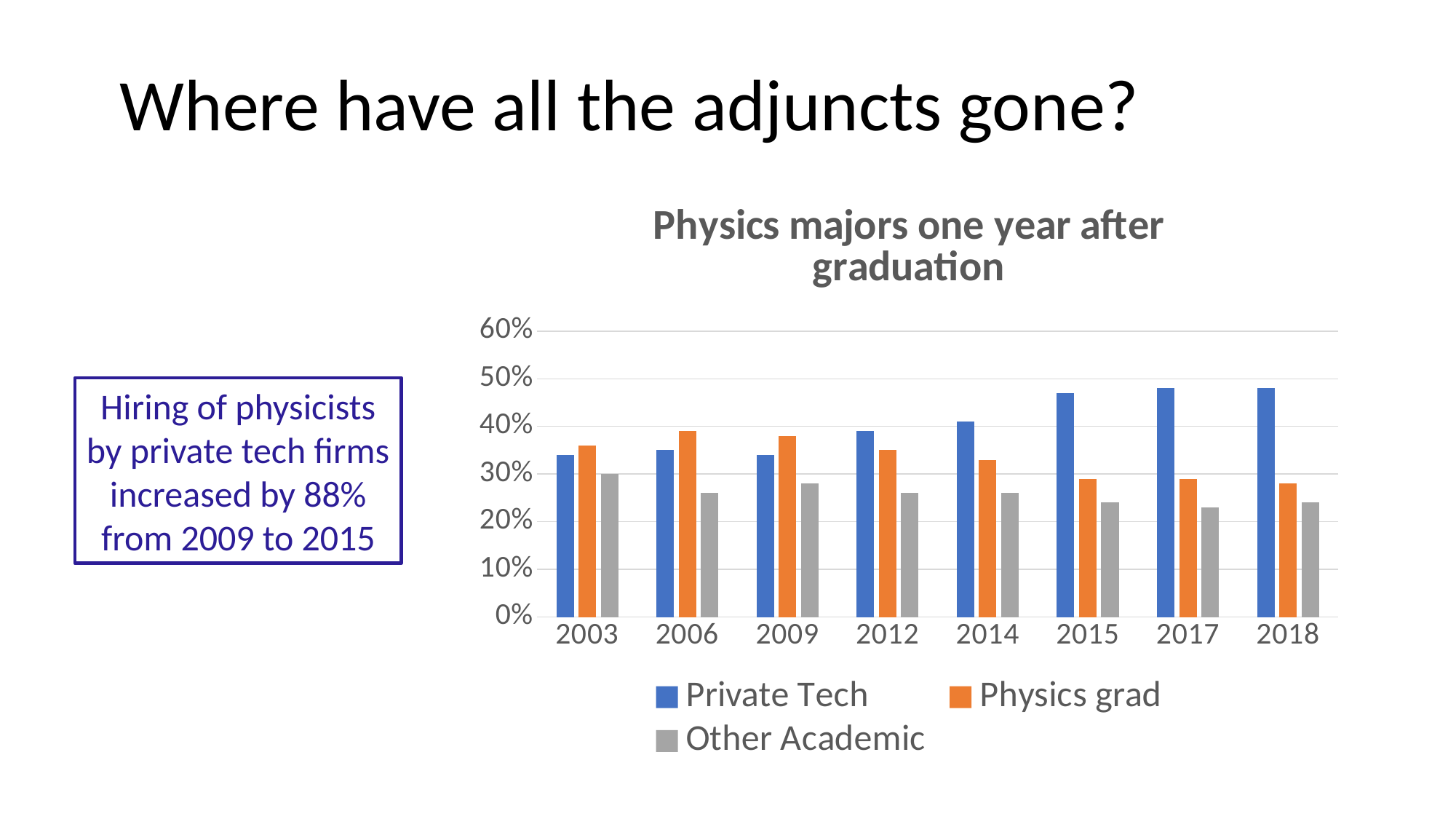
What is the title of the chart? Physics majors one year after graduation Does the Private Tech series generally rise or fall from 2003 to 2018? rise In 2018, which is larger: the Private Tech value or the Other Academic value? Private Tech In which year is the Other Academic value highest? 2003 Is the Physics grad value for 2018 greater or less than 30%? less Is the Private Tech value for 2015 greater or less than 40%? greater Which series is shown in orange in the chart? Physics grad What kind of chart is shown on the slide? Bar chart Is the Private Tech value for 2003 greater or less than 40%? less How many years are shown on the x axis of the chart? 8 How many series does the chart's legend list? 3